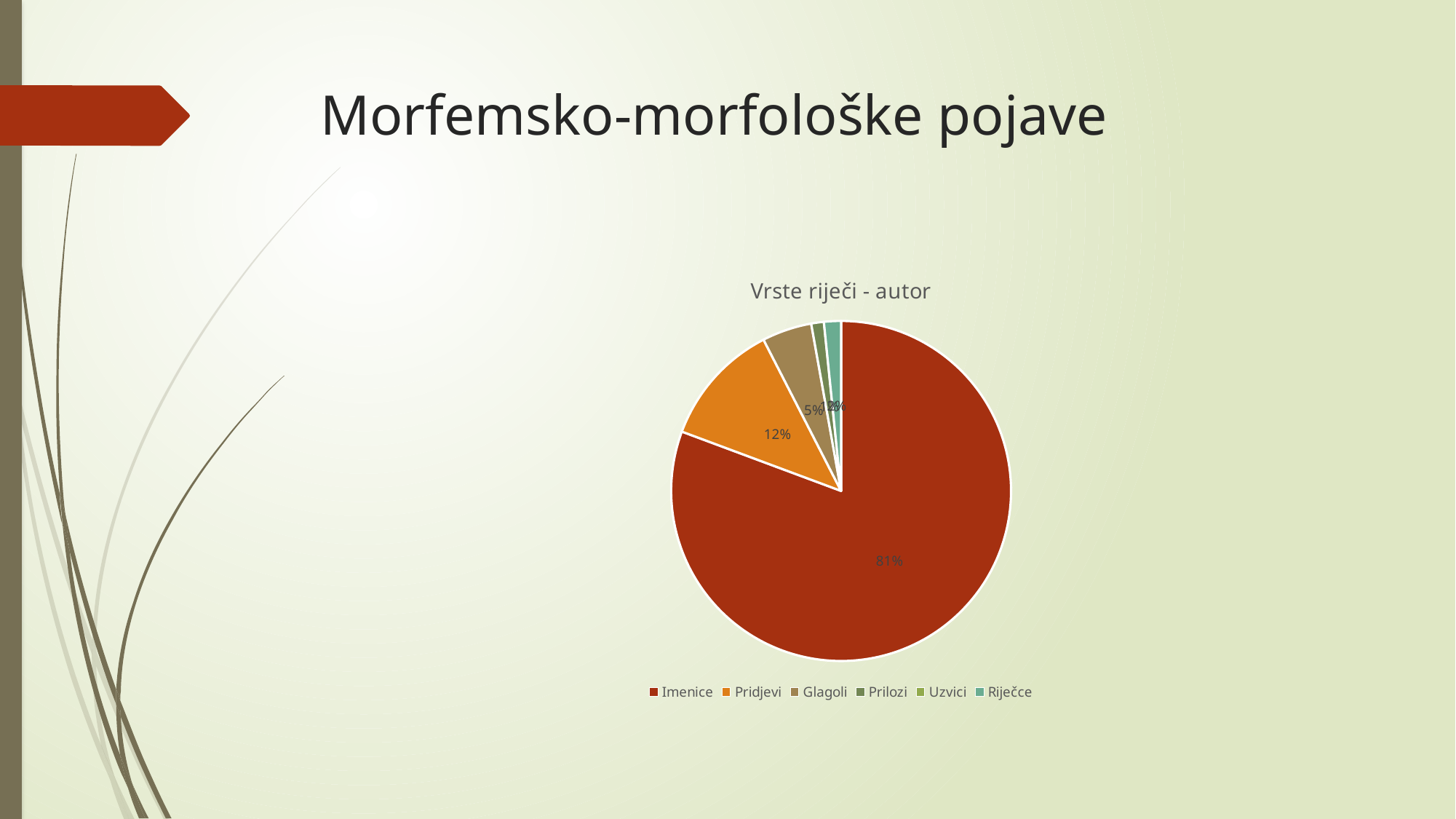
Which legend entry is shown in orange? Pridjevi What share of the pie does Glagoli have? 5% What is the difference in percentage points between the Imenice slice and the Pridjevi slice? 69 What kind of chart is shown on the slide? pie chart Which is larger, the slice for Imenice or the slice for Pridjevi? Imenice What share of the pie does Imenice have? 81% Which is larger, the slice for Pridjevi or the slice for Glagoli? Pridjevi What share of the pie does Pridjevi have? 12% What is the title of the chart? Vrste riječi - autor Which category has the largest slice of the pie? Imenice What is the difference in percentage points between the Pridjevi slice and the Glagoli slice? 7 How many categories does the legend list? 6